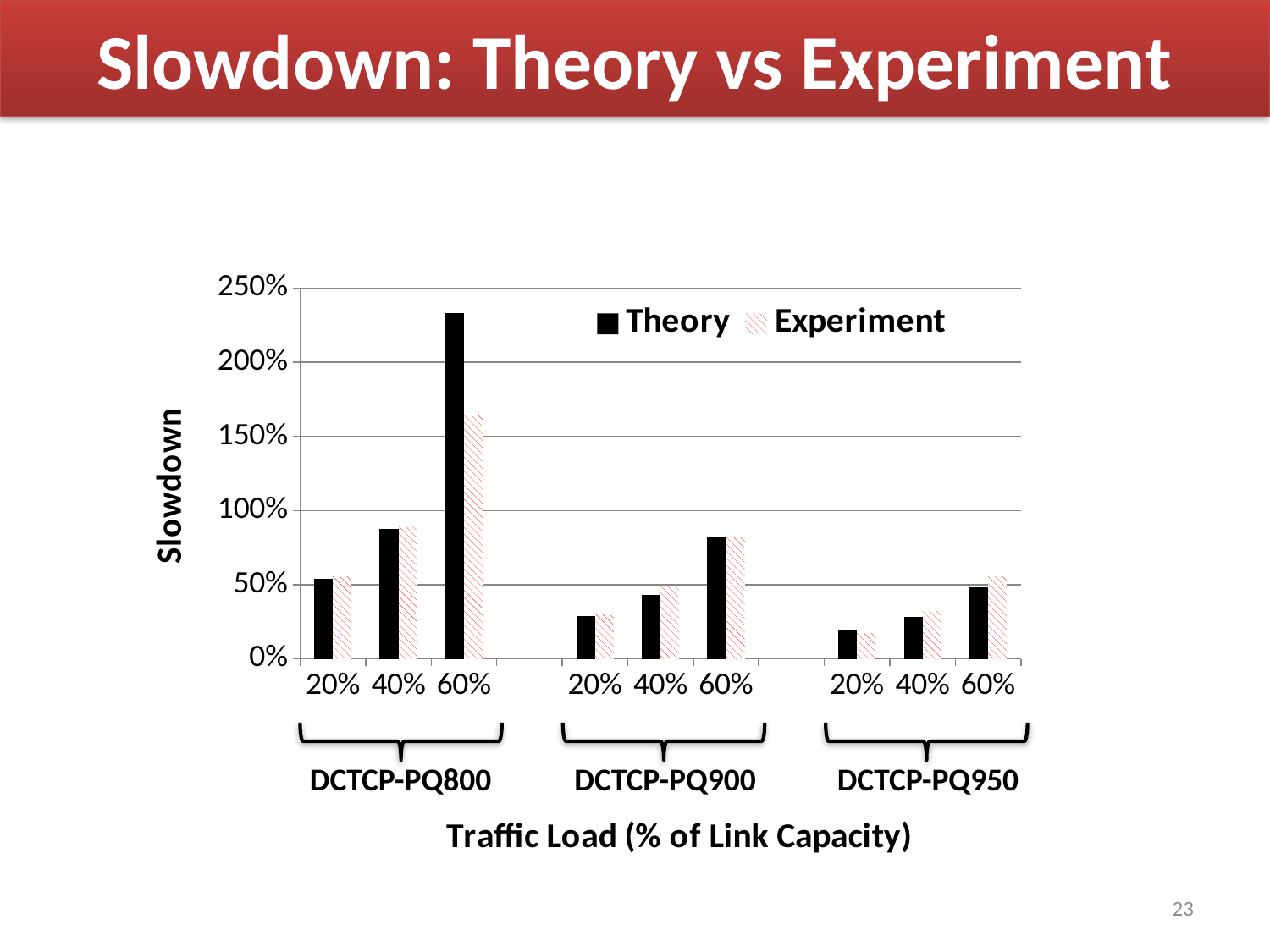
What are the two series named in the legend? Theory and Experiment Which bar has the lowest Theory slowdown? DCTCP-PQ950 at 20% load Is the Experiment slowdown for DCTCP-PQ800 at 60% load greater or less than 150%? greater Which bar has the highest Theory slowdown? DCTCP-PQ800 at 60% load Within the DCTCP-PQ900 group, do the Theory slowdown bars rise or fall as traffic load increases from 20% to 60%? rise How many DCTCP configurations are grouped along the x axis? 3 For DCTCP-PQ800 at 60% load, which is larger, the Theory or the Experiment slowdown? Theory Is the Theory slowdown for DCTCP-PQ800 at 60% load greater or less than 200%? greater How many series does the legend list? 2 Is the Theory slowdown for DCTCP-PQ900 at 20% load greater or less than 50%? less What is the title of the x axis? Traffic Load (% of Link Capacity) What kind of chart is shown on the slide? bar chart